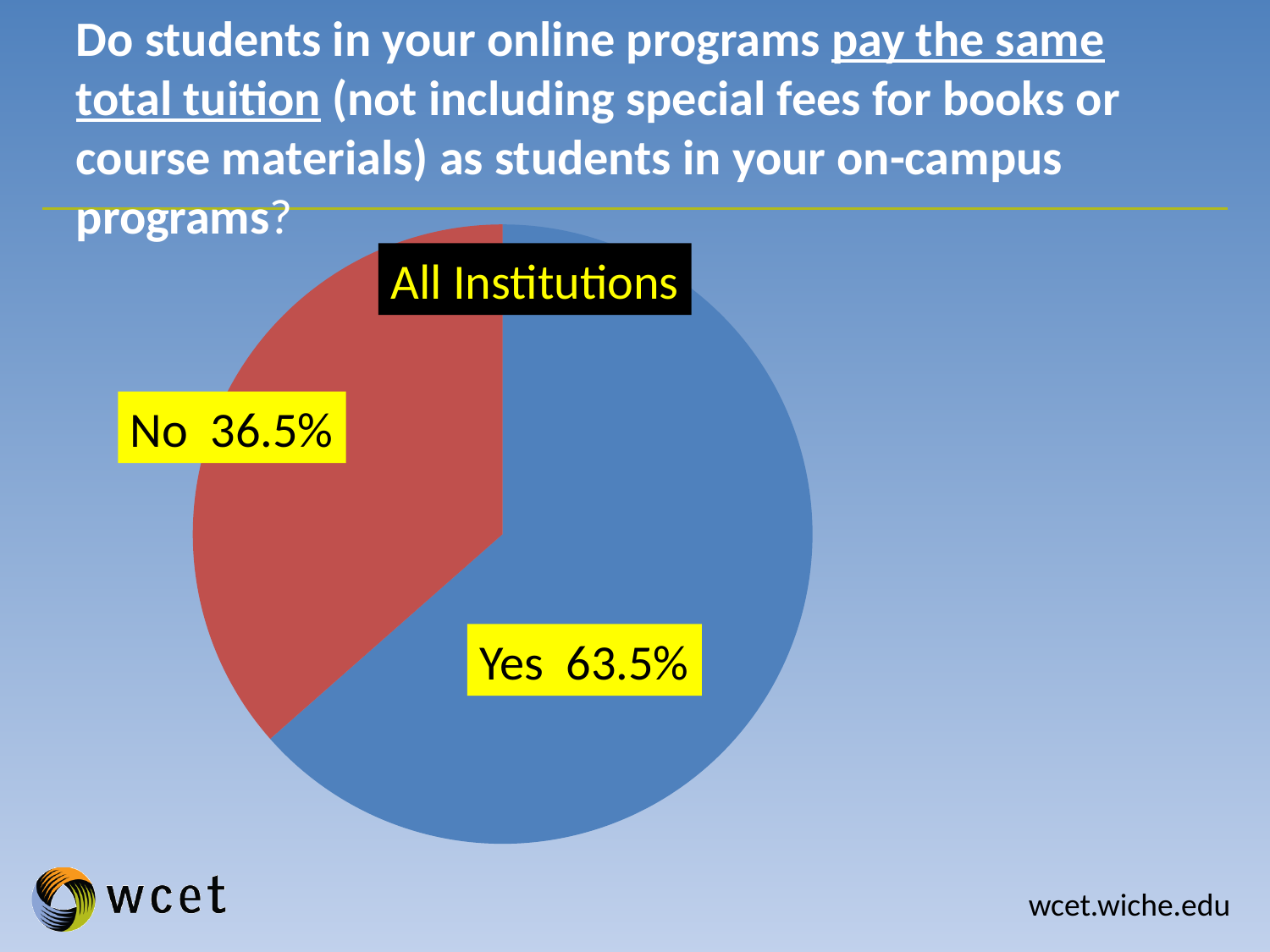
Which response has the smallest share of the pie? No What is the share of the pie taken by the No slice? 36.5% What percentage of institutions answered No? 36.5% What is the difference in percentage points between the Yes and No shares? 27 percentage points What is the title shown on the pie chart? All Institutions What percentage of institutions answered Yes? 63.5% Which response has the largest share of the pie? Yes What colour is the Yes slice of the pie chart? blue What type of chart is shown on the slide? pie chart Which is larger, the Yes share or the No share? Yes How many slices does the pie chart have? 2